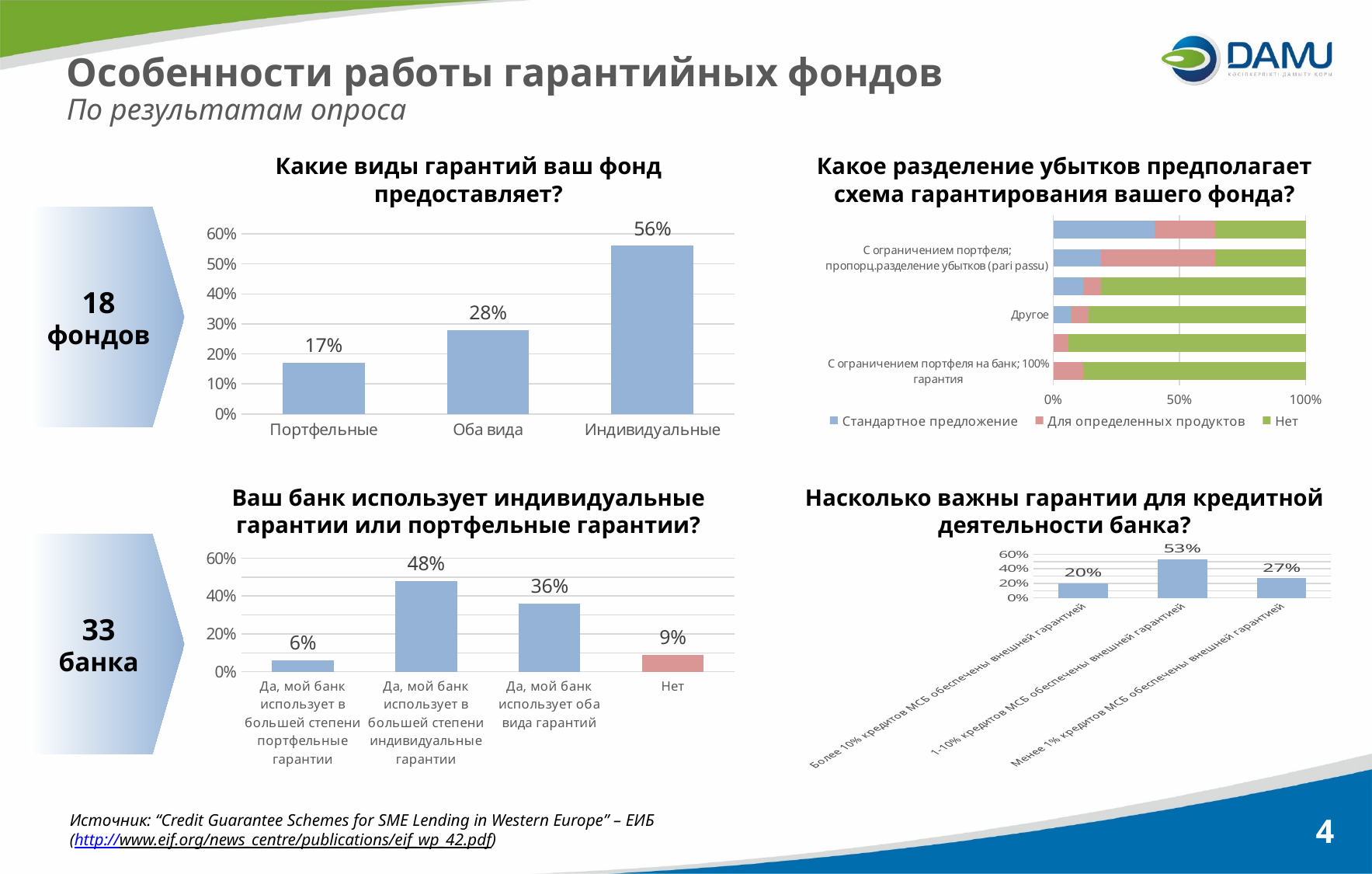
How many series does the legend of the chart "Какое разделение убытков предполагает схема гарантирования вашего фонда?" list? 3 In the chart "Ваш банк использует индивидуальные гарантии или портфельные гарантии?", what is the value for Нет? 9% In the chart "Насколько важны гарантии для кредитной деятельности банка?", what is the value for "1-10% кредитов МСБ обеспечены внешней гарантией"? 53% In the chart "Какие виды гарантий ваш фонд предоставляет?", what is the difference between Индивидуальные and Оба вида? 28% In the chart "Какие виды гарантий ваш фонд предоставляет?", how many categories are shown? 3 In the chart "Какие виды гарантий ваш фонд предоставляет?", what is the value for Индивидуальные? 56% In the chart "Ваш банк использует индивидуальные гарантии или портфельные гарантии?", which category has the highest value? Да, мой банк использует в большей степени индивидуальные гарантии What kind of chart is "Какое разделение убытков предполагает схема гарантирования вашего фонда?"? Stacked horizontal bar chart In the chart "Ваш банк использует индивидуальные гарантии или портфельные гарантии?", what is the difference between the 48% bar and the 36% bar? 12% In the chart "Какие виды гарантий ваш фонд предоставляет?", which category has the lowest value? Портфельные In the chart "Насколько важны гарантии для кредитной деятельности банка?", which category has the lowest value? Более 10% кредитов МСБ обеспечены внешней гарантией In the chart "Ваш банк использует индивидуальные гарантии или портфельные гарантии?", which is larger: the value for "Да, мой банк использует оба вида гарантий" or the value for "Нет"? Да, мой банк использует оба вида гарантий